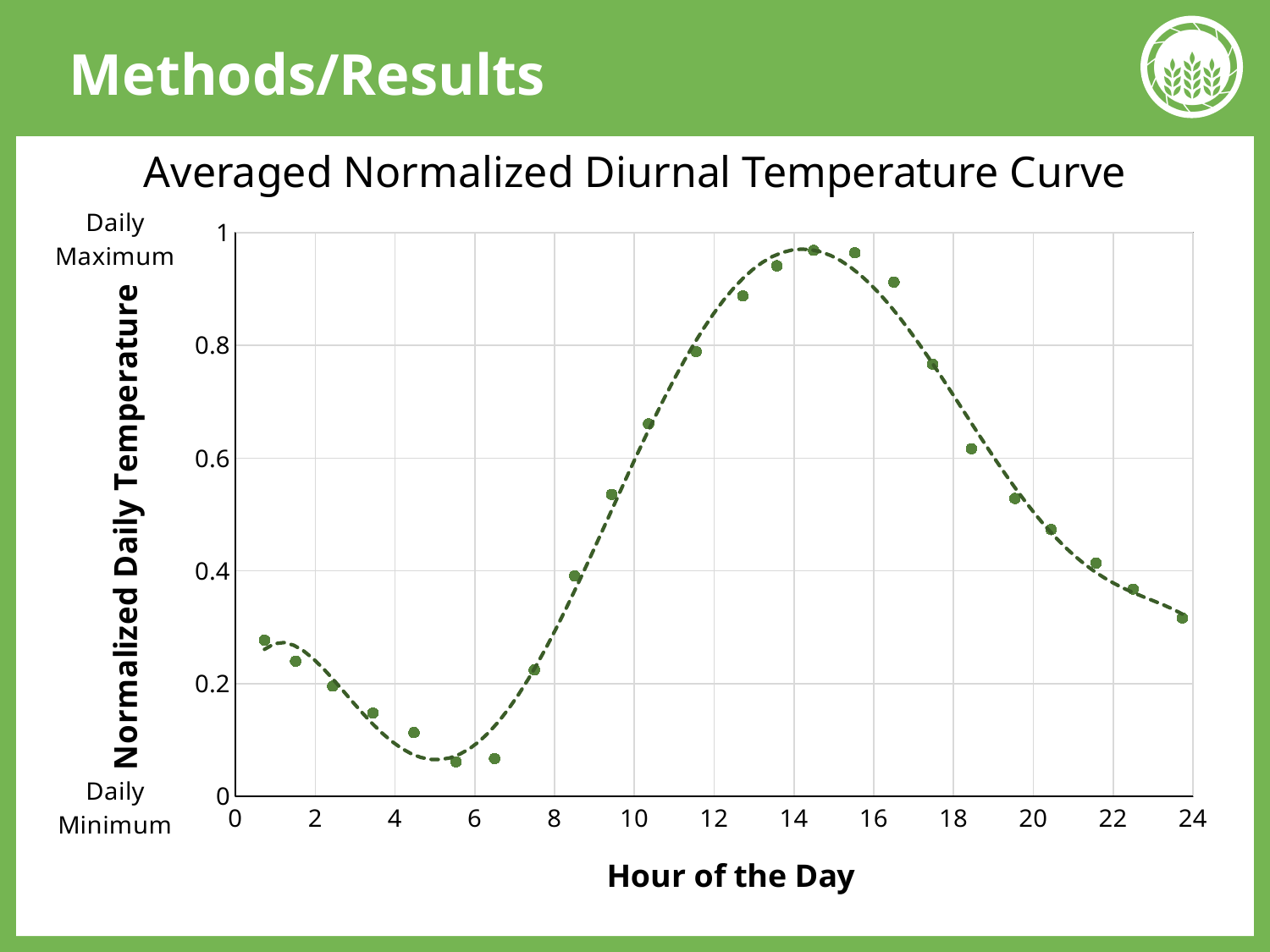
Is the value for the point near hour 20.5 greater or less than 0.6? less What kind of chart is shown on the slide? scatter chart Is the value for the point near hour 14 greater or less than 0.8? greater Is the value for the point near hour 10.5 greater or less than 0.4? greater What is the x-axis title of the chart? Hour of the Day How many data points are plotted on the chart? 24 What is the title of the chart? Averaged Normalized Diurnal Temperature Curve Which point has the larger value: the one near hour 12.5 or the one near hour 2.5? the one near hour 12.5 Which point has the larger value: the one near hour 10.5 or the one near hour 20.5? the one near hour 10.5 Do the values rise or fall along the x axis between hour 6 and hour 14? rise Do the values rise or fall along the x axis between hour 16 and hour 24? fall